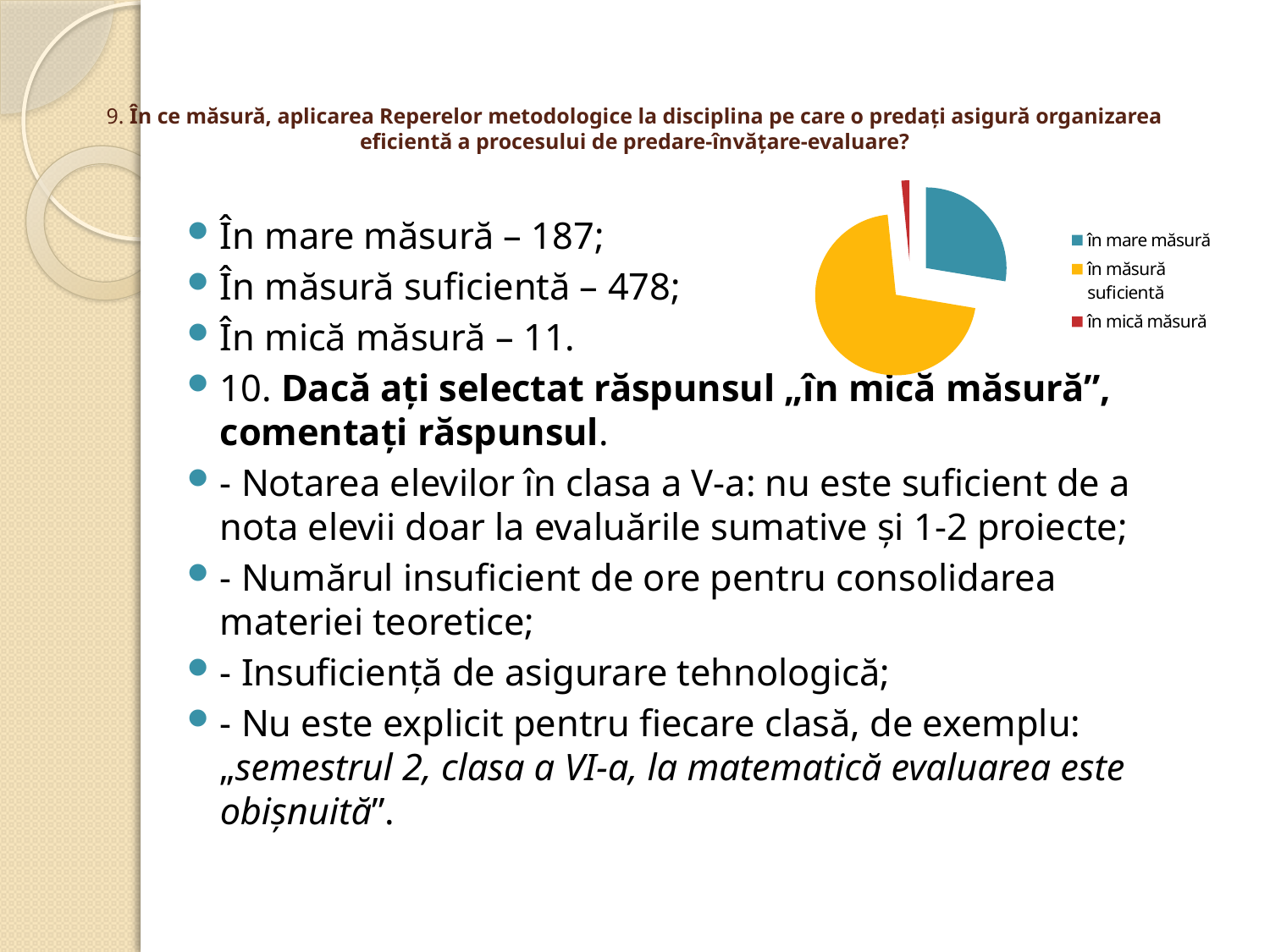
Which category has the largest slice in the pie chart? în măsură suficientă What kind of chart is shown on the slide? pie chart According to the slide, what is the value for În mare măsură? 187 How many entries does the legend of the pie chart list? 3 What is the total of the three values shown for the pie chart? 676 How many slices does the pie chart have? 3 What is the difference between the values for În măsură suficientă and În mare măsură? 291 According to the slide, what is the value for În măsură suficientă? 478 Which category has the smallest slice in the pie chart? în mică măsură According to the slide, what is the value for În mică măsură? 11 What colour is the slice for în mică măsură in the pie chart? red Which slice is larger in the pie chart: în mare măsură or în mică măsură? în mare măsură